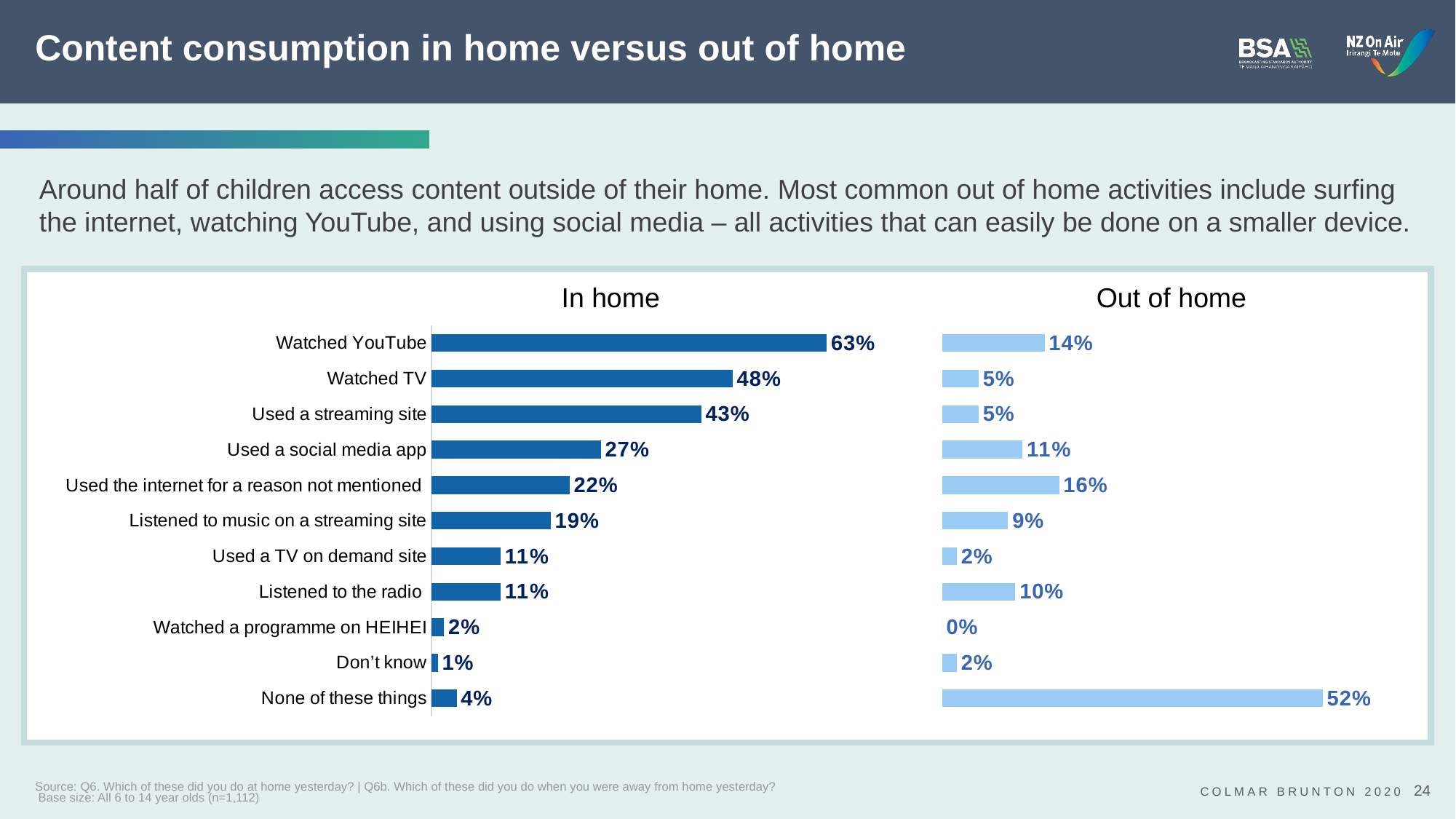
What is the difference between the 'In home' and 'Out of home' values for 'Watched TV'? 43% In the 'In home' chart, what is the value for 'Watched YouTube'? 63% In the 'Out of home' chart, which is larger: 'Used a social media app' or 'Listened to the radio'? Used a social media app In the 'Out of home' chart, which category has the lowest value? Watched a programme on HEIHEI What is the title of the chart on the right side of the slide? Out of home In the 'Out of home' chart, what is the value for 'None of these things'? 52% In the 'In home' chart, which category has the lowest value? Don't know What type of chart is used for the 'In home' data? Bar chart In the 'In home' chart, which category has the highest value? Watched YouTube In the 'In home' chart, what is the difference between 'Watched YouTube' and 'Used a streaming site'? 20% In the 'Out of home' chart, what is the value for 'Used the internet for a reason not mentioned'? 16% How many categories are shown in the 'In home' chart? 11